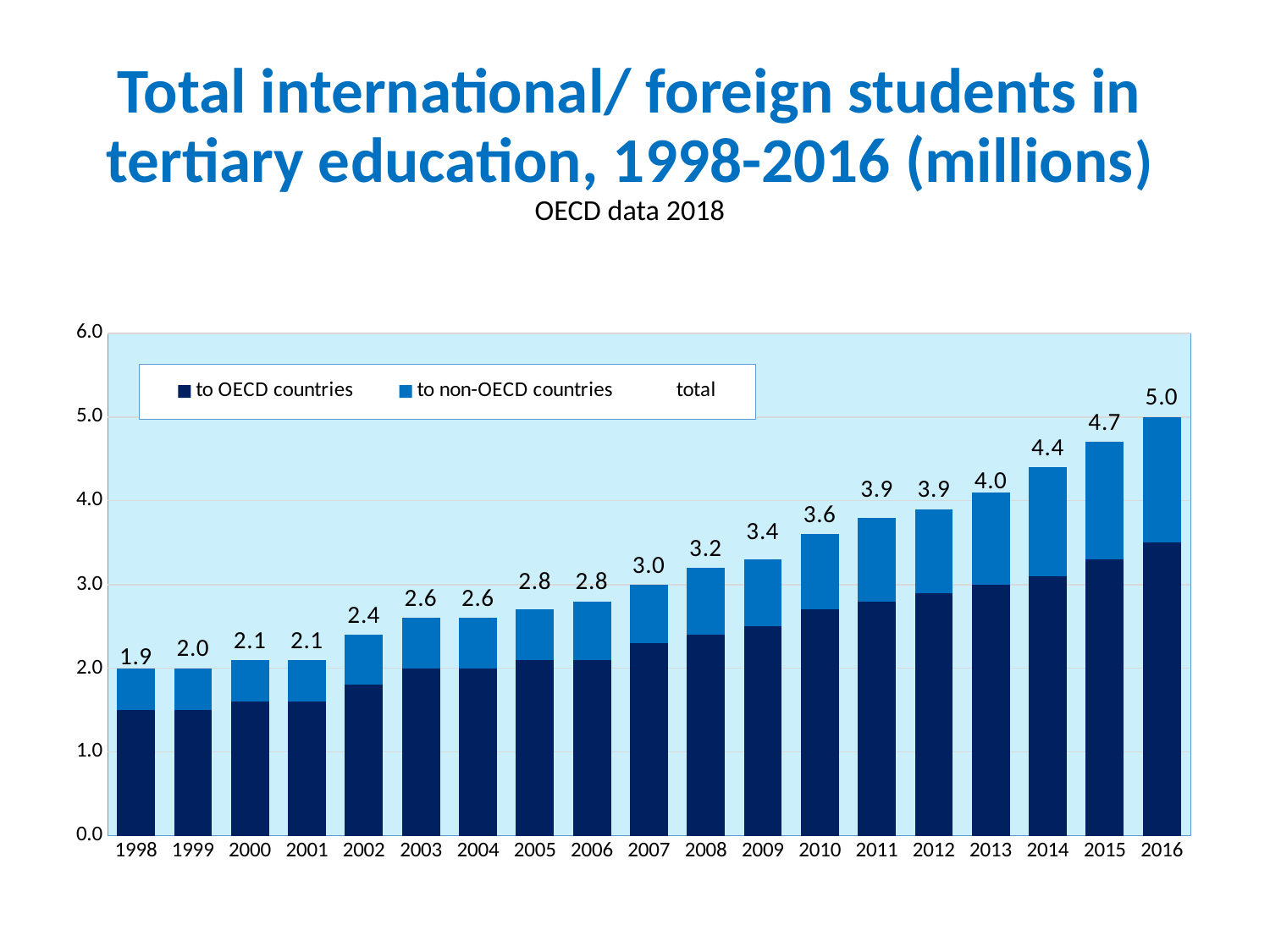
Is the value for 'to OECD countries' in 2016 greater or less than 3.0? greater How many years are shown on the x axis? 19 Do the totals rise or fall from 1998 to 2016? rise How many entries does the legend list? 3 What is the total value labelled for 2008? 3.2 Which year has the highest total? 2016 Which year has the lowest total? 1998 What is the difference between the total for 2016 and the total for 1998? 3.1 What is the total value labelled for 2002? 2.4 What is the total number of international/foreign students shown for 2016? 5.0 Which is larger, the total for 2005 or the total for 2009? 2009 What is the difference between the total for 2014 and the total for 2010? 0.8